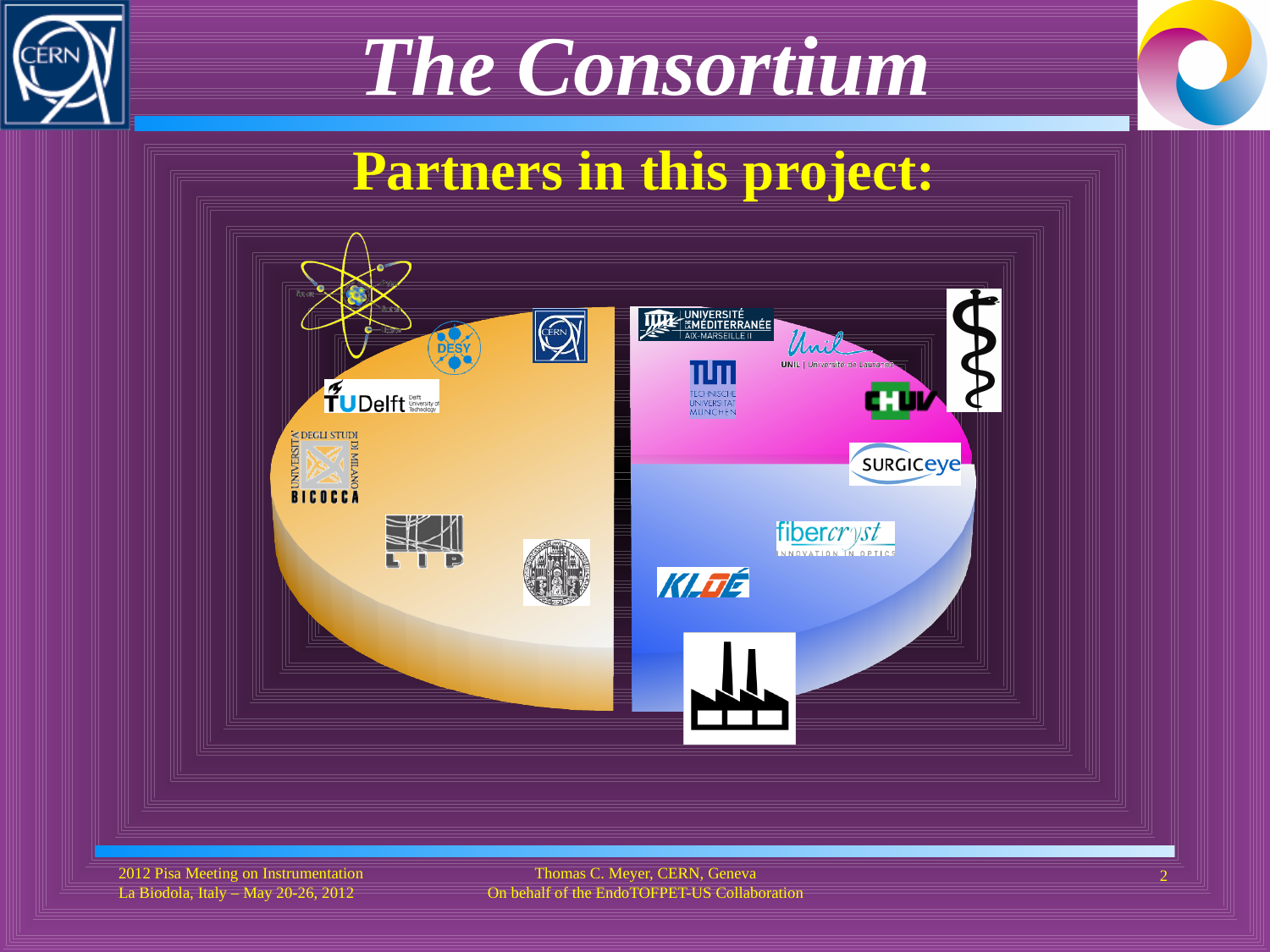
Which slice of the pie chart is the largest? the orange slice What kind of chart is shown on the slide? pie chart Which is larger, the orange slice or the pink slice of the pie chart? the orange slice Which is larger, the orange slice or the blue slice of the pie chart? the orange slice What colours are the three slices of the pie chart? orange, pink and blue What heading appears directly above the pie chart? Partners in this project: How many slices does the pie chart have? 3